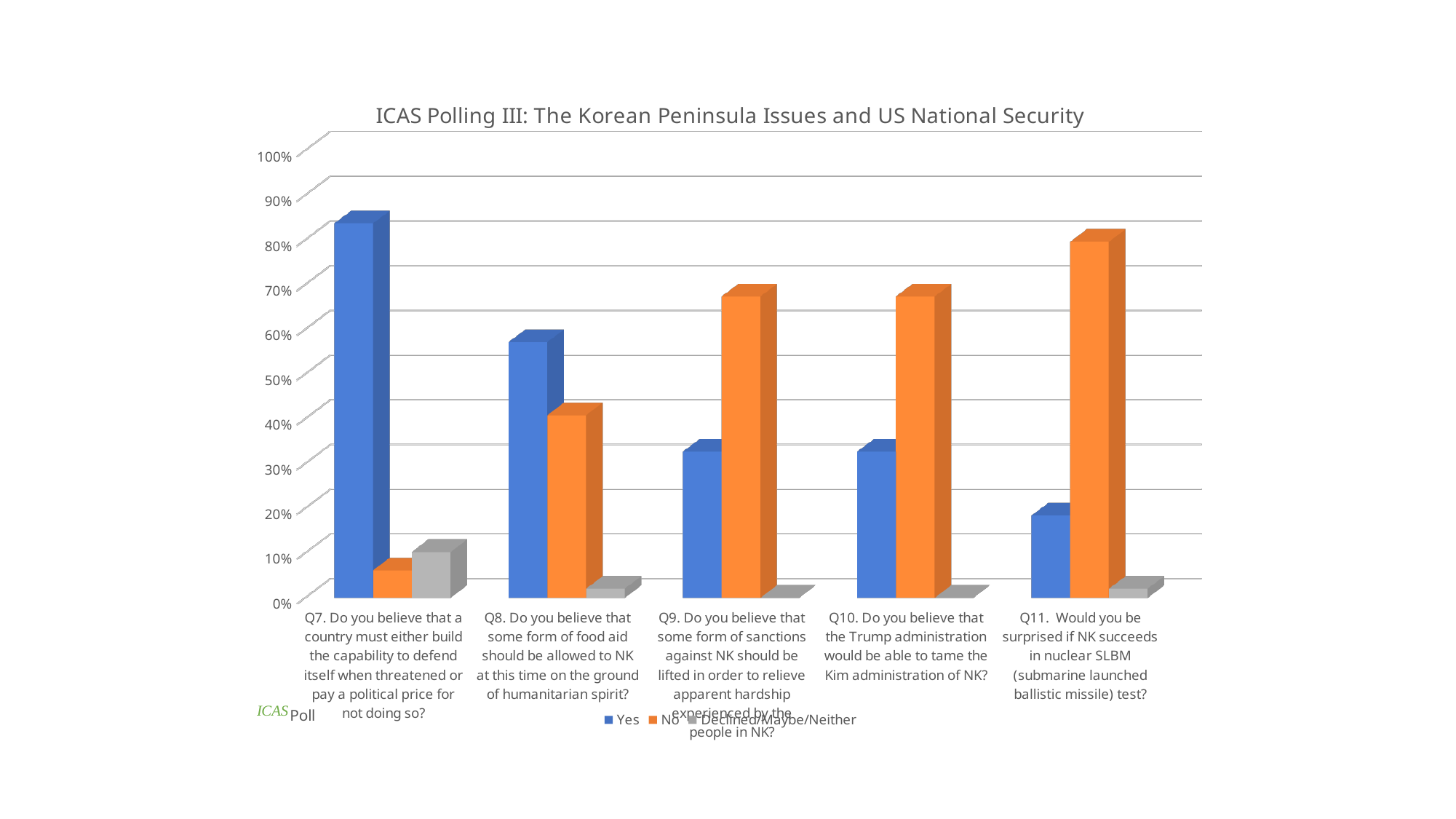
How many series does the legend list? 3 Is the 'No' value for Q11 greater or less than 70%? greater For Q8, which is larger, the 'Yes' value or the 'No' value? Yes What kind of chart is shown on the slide? Bar chart For Q9, which is larger, the 'Yes' value or the 'No' value? No Is the 'Yes' value for Q7 greater or less than 70%? greater Which question has the highest 'No' value? Q11 How many questions (categories) are plotted on the x axis? 5 What is the title of the chart? ICAS Polling III: The Korean Peninsula Issues and US National Security Which question has the lowest 'Yes' value? Q11 Which question has the highest 'Yes' value? Q7 Is the 'Yes' value for Q8 greater or less than 50%? greater